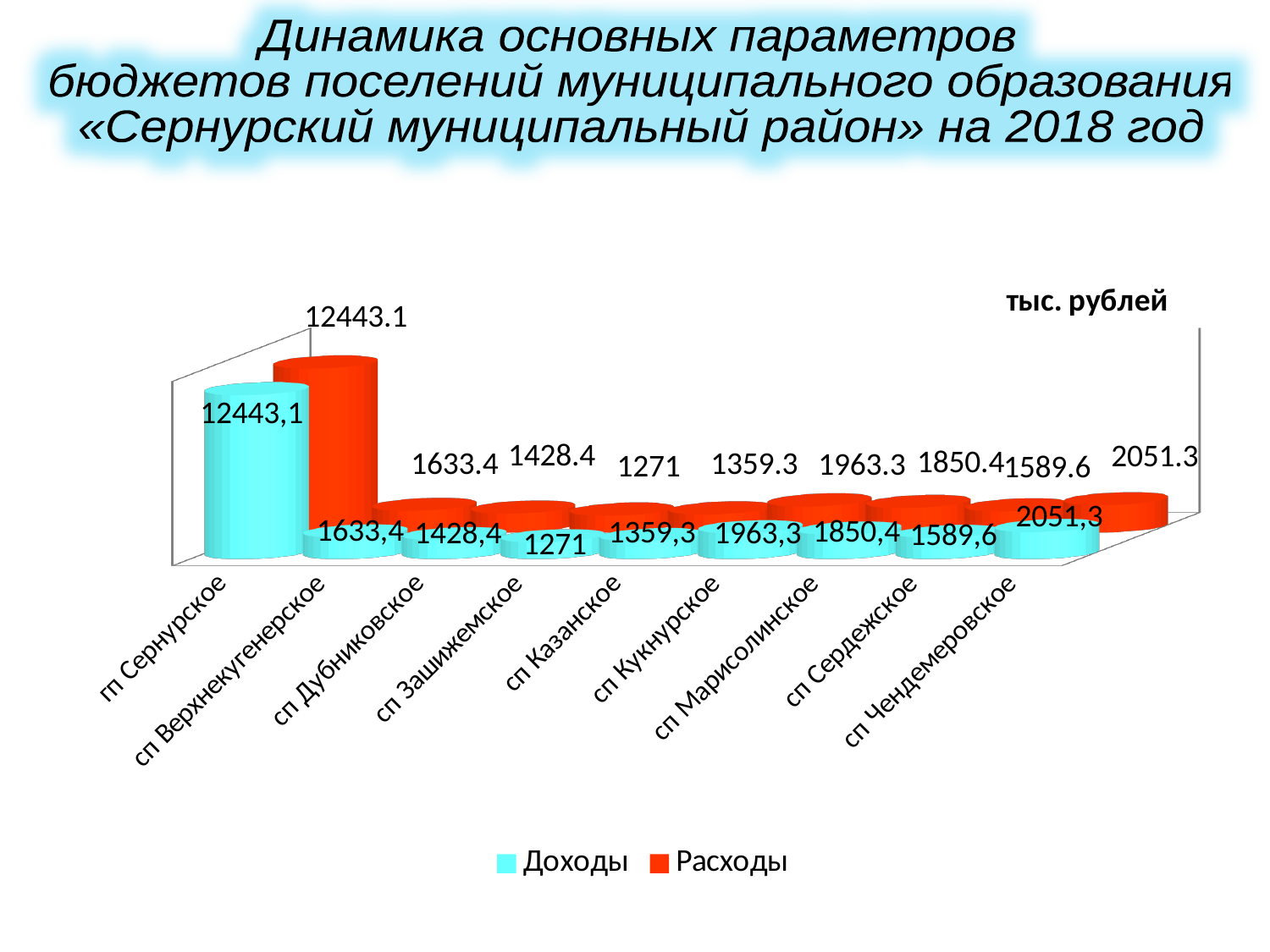
What is the difference between the Расходы values for сп Чендемеровское and сп Марисолинское? 200.9 Which category has the highest Доходы value? гп Сернурское What is the Доходы value for гп Сернурское? 12443,1 How many categories are shown on the x axis? 9 Which category has the lowest Расходы value? сп Зашижемское What is the Расходы value for сп Зашижемское? 1271 What is the Доходы value for сп Кукнурское? 1963,3 What kind of chart is shown on the slide? Bar chart Which is larger, the Доходы value for сп Чендемеровское or for сп Марисолинское? сп Чендемеровское What unit is indicated above the chart? тыс. рублей How many series does the legend list? 2 What is the Расходы value for сп Чендемеровское? 2051.3